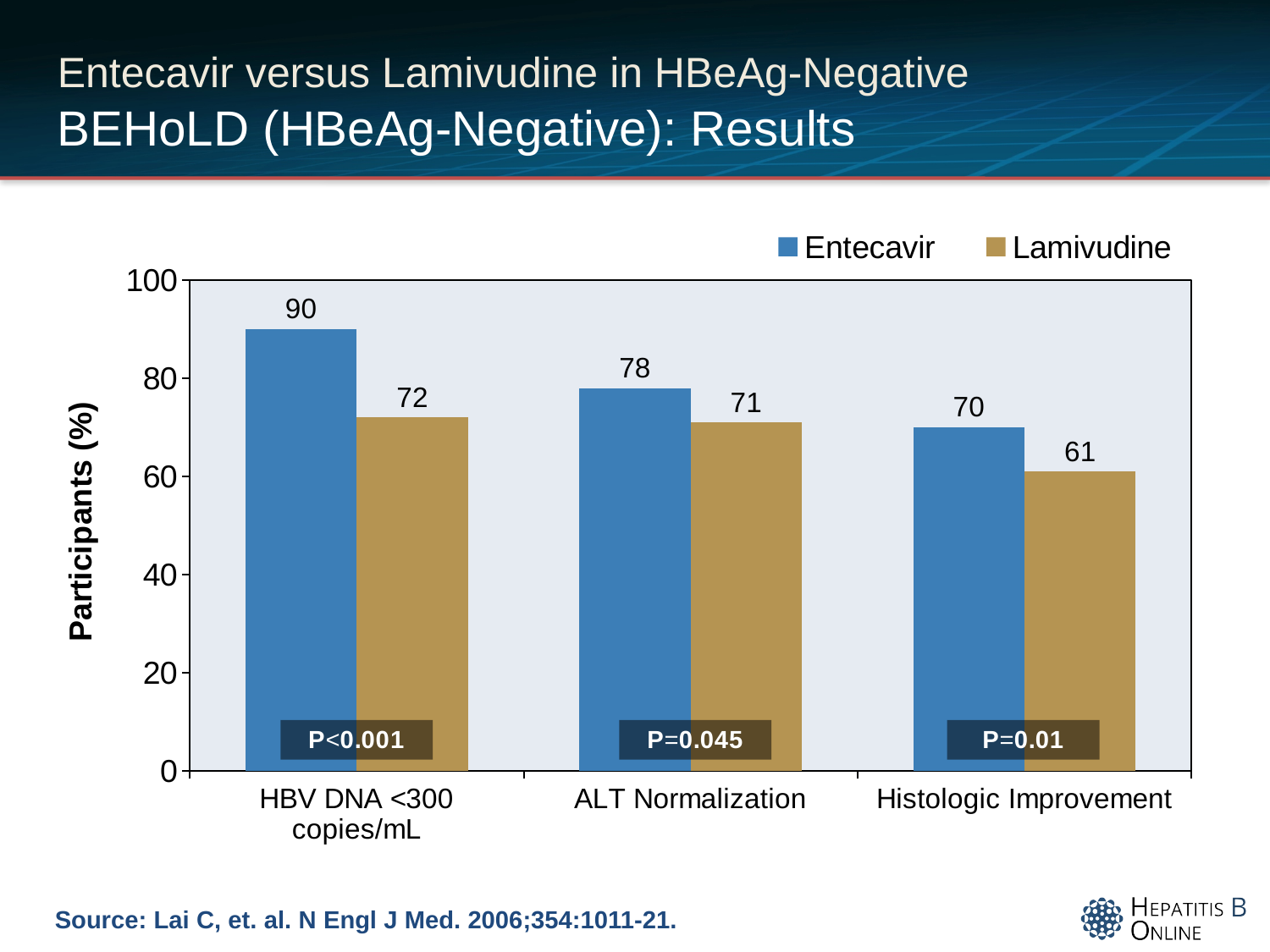
What kind of chart is shown on the slide? Bar chart What percentage of Entecavir participants achieved HBV DNA <300 copies/mL? 90 Which category has the lowest value for Lamivudine? Histologic Improvement Which is larger for ALT Normalization, Entecavir or Lamivudine? Entecavir Which category has the highest value for Entecavir? HBV DNA <300 copies/mL How many categories are shown on the x axis? 3 What is the difference between Entecavir and Lamivudine for HBV DNA <300 copies/mL? 18 How many series does the legend list? 2 What is the value for Lamivudine in the Histologic Improvement category? 61 What is the y-axis label of the chart? Participants (%) What is the value for Lamivudine for ALT Normalization? 71 What is the difference between Entecavir and Lamivudine for Histologic Improvement? 9